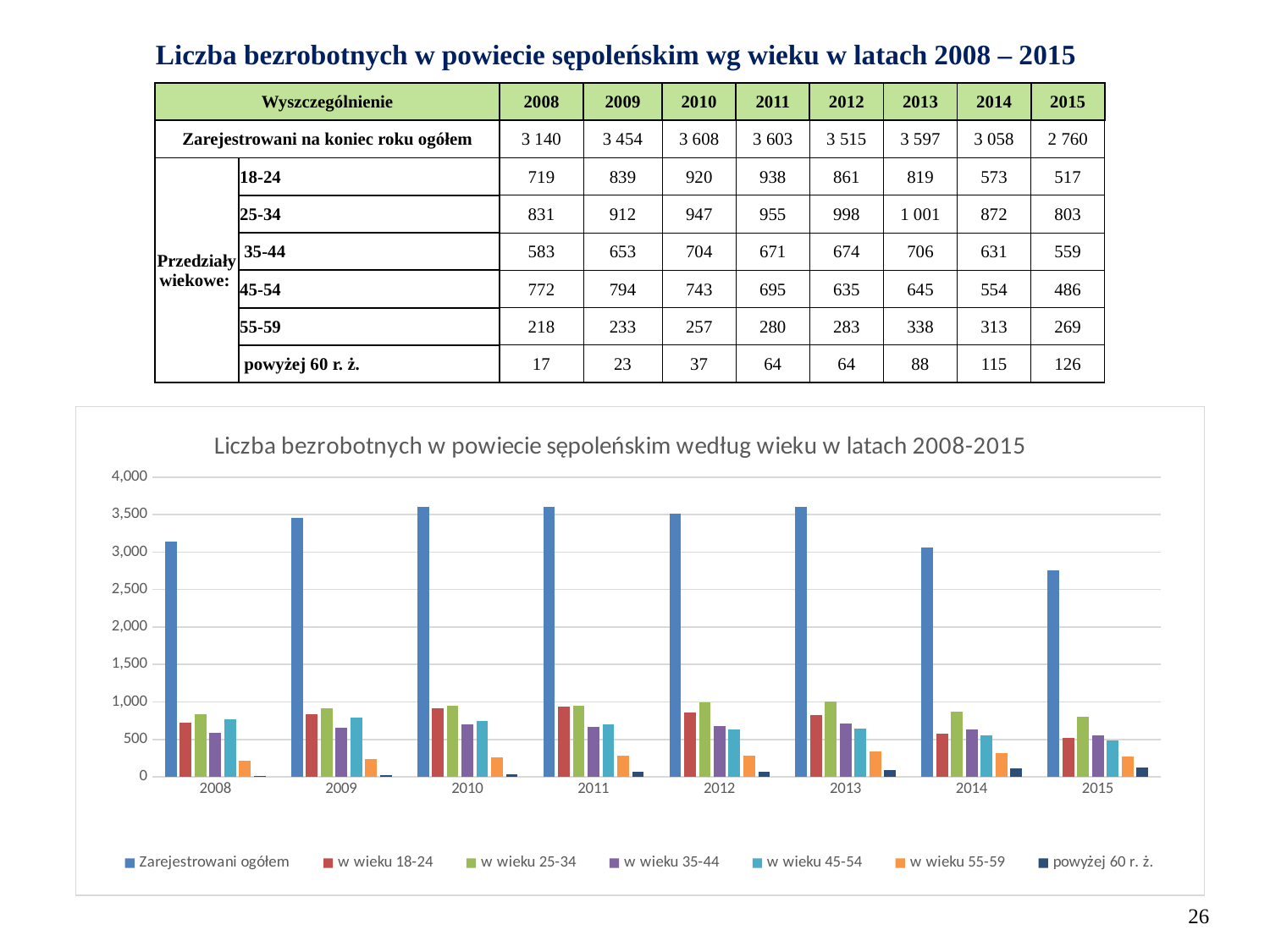
What is the difference between Zarejestrowani ogółem in 2008 and in 2015? 380 How many series does the chart legend list? 7 What is the value of Zarejestrowani ogółem for 2008? 3 140 Is the value of Zarejestrowani ogółem for 2015 greater or less than 3,000? less In which year is Zarejestrowani ogółem lowest? 2015 In which year is the value for powyżej 60 r. ż. highest? 2015 What is the title of the chart? Liczba bezrobotnych w powiecie sępoleńskim według wieku w latach 2008-2015 How many years are shown along the x axis of the chart? 8 Does the value for powyżej 60 r. ż. rise or fall from 2008 to 2015? rises What is the value for w wieku 18-24 in 2011? 938 What kind of chart is shown on the slide? bar chart In 2012, which is larger: w wieku 18-24 or w wieku 45-54? w wieku 18-24